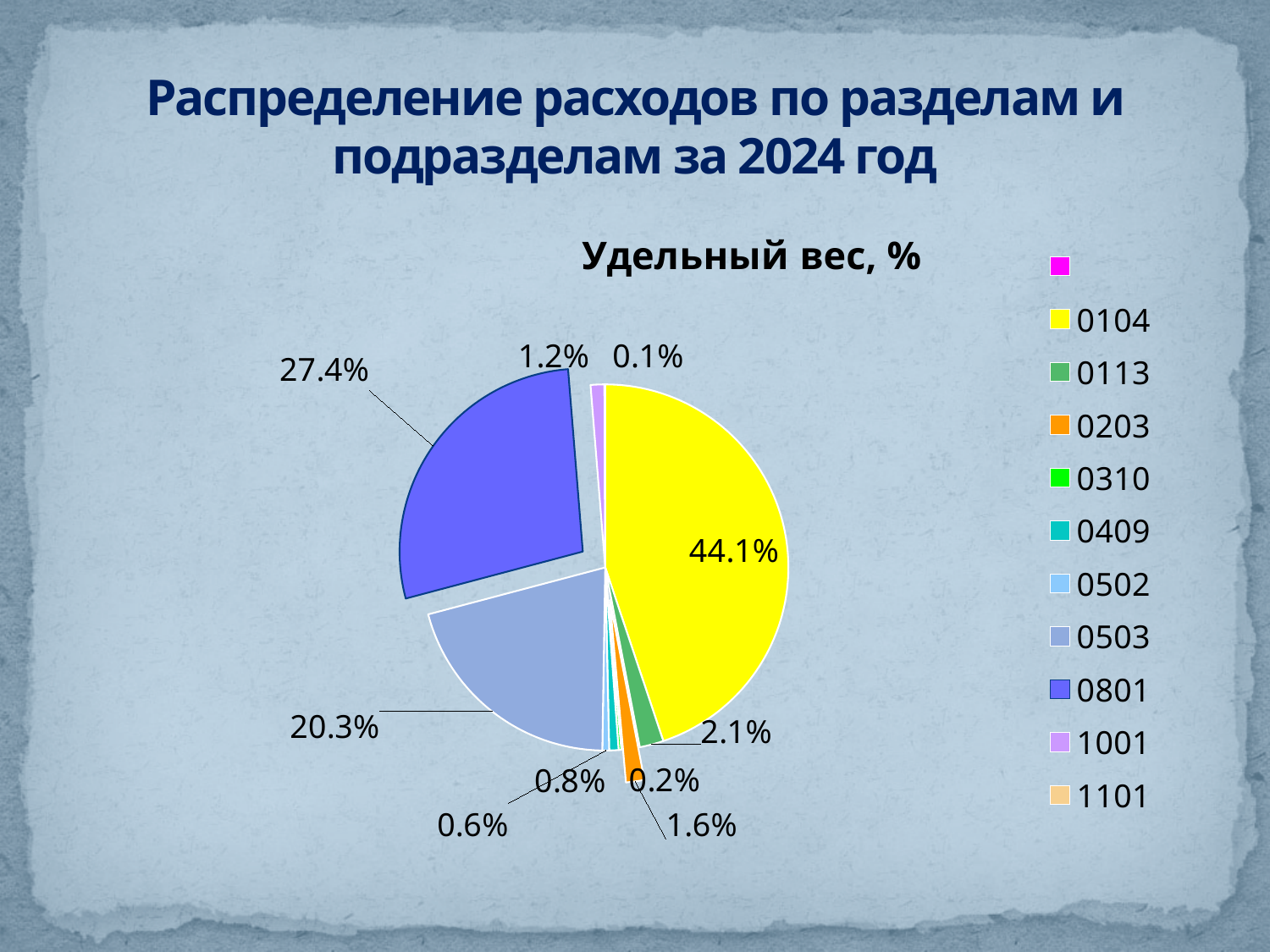
By how many percentage points does the share of 0104 exceed the share of 0801? 16.7 percentage points What is the title of the pie chart? Удельный вес, % Which has the larger share, section 0801 or section 0503? 0801 What is the share for section 0503? 20.3% What is the share for section 0104? 44.1% Which section has the largest share of the pie? 0104 What is the share for section 0113? 2.1% What is the share for section 1001? 1.2% What kind of chart is shown on the slide? Pie chart What is the share for section 0203? 1.6% What is the difference between the shares of 0801 and 0503? 7.1 percentage points What is the share for section 0801? 27.4%